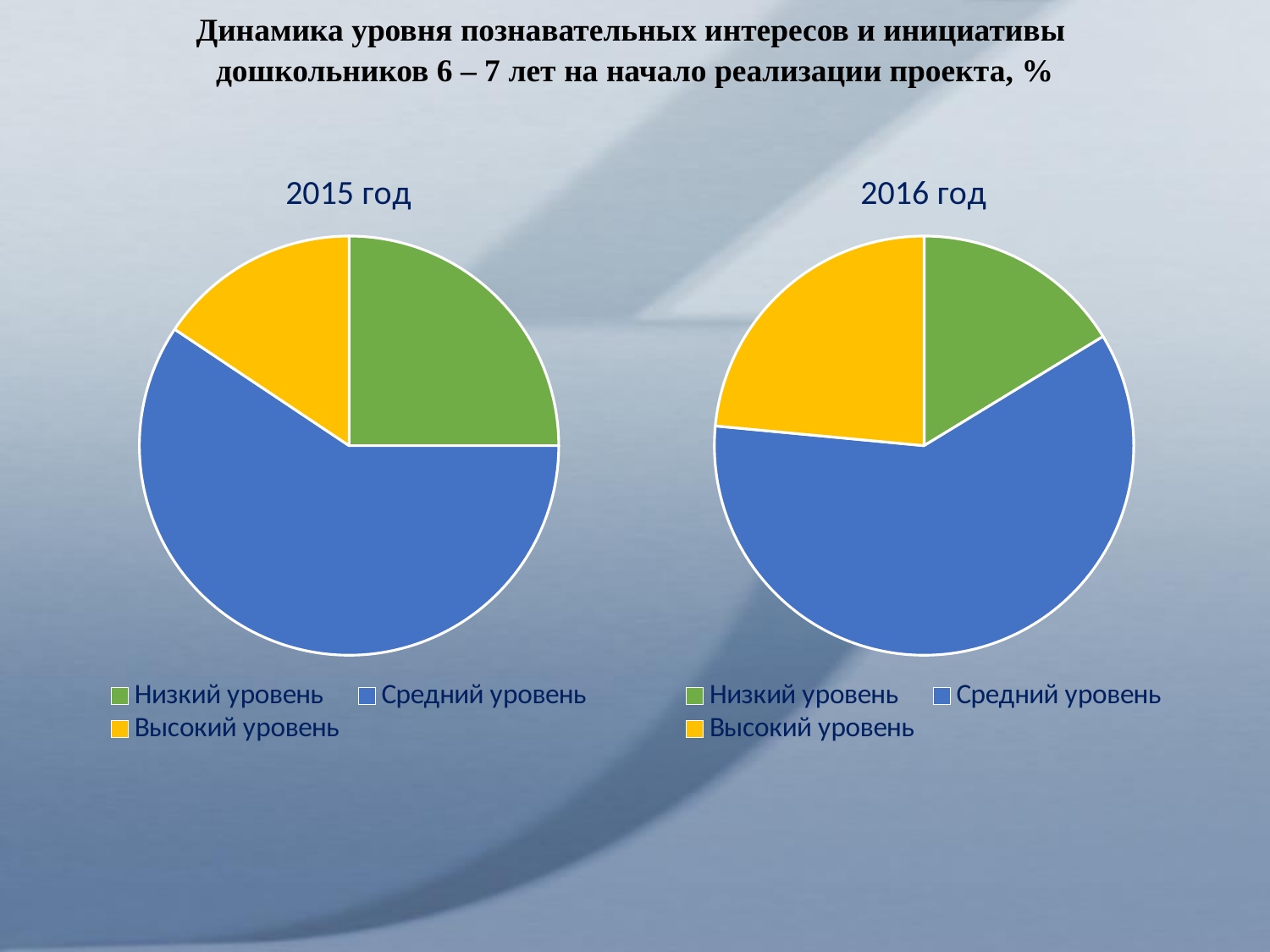
In the "2016 год" chart, which slice is larger: Высокий уровень or Низкий уровень? Высокий уровень In the "2015 год" chart, which colour represents Высокий уровень? yellow In the "2015 год" chart, which category has the largest slice? Средний уровень In the "2015 год" chart, which slice is larger: Низкий уровень or Высокий уровень? Низкий уровень How many entries does the legend of the "2016 год" chart list? 3 What are the titles of the two pie charts on the slide? 2015 год and 2016 год In the "2016 год" chart, which category has the largest slice? Средний уровень How many slices does the "2015 год" pie chart have? 3 What kind of chart is the "2015 год" chart? pie chart In the "2015 год" chart, which category has the smallest slice? Высокий уровень What kind of chart is the "2016 год" chart? pie chart In the "2016 год" chart, which category has the smallest slice? Низкий уровень